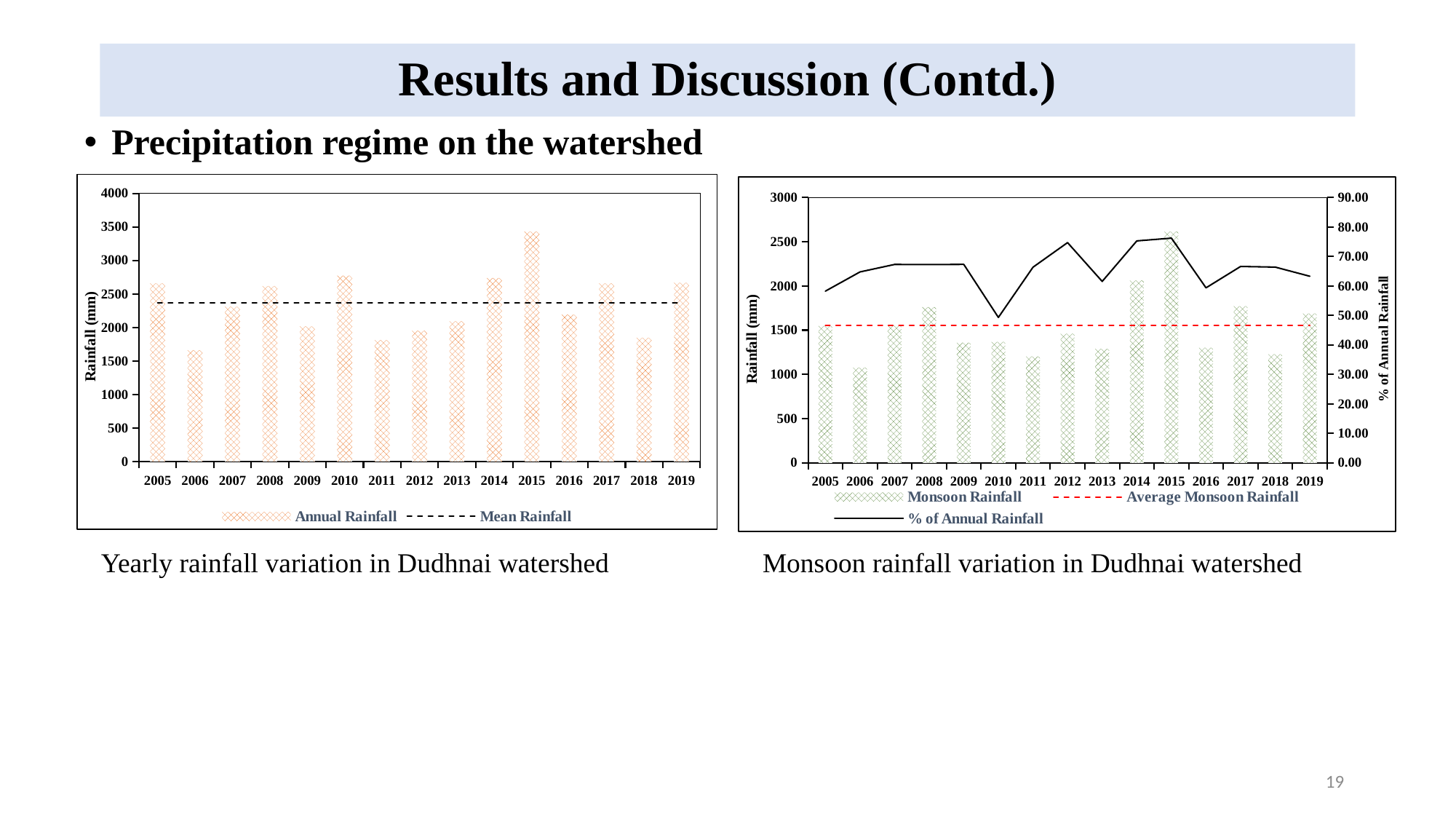
In the left chart (Yearly rainfall variation in Dudhnai watershed), which year has the larger annual rainfall, 2010 or 2011? 2010 In the left chart (Yearly rainfall variation in Dudhnai watershed), how many years are shown on the x axis? 15 In the left chart (Yearly rainfall variation in Dudhnai watershed), is the annual rainfall for 2015 greater or less than 3000? greater In the left chart (Yearly rainfall variation in Dudhnai watershed), is the annual rainfall for 2006 greater or less than 2000? less In the left chart (Yearly rainfall variation in Dudhnai watershed), what kind of chart is used to show Annual Rainfall? bar chart In the right chart (Monsoon rainfall variation in Dudhnai watershed), what is the title of the secondary (right) y axis? % of Annual Rainfall In the right chart (Monsoon rainfall variation in Dudhnai watershed), which year has the highest monsoon rainfall? 2015 In the left chart (Yearly rainfall variation in Dudhnai watershed), which year has the highest annual rainfall? 2015 In the left chart (Yearly rainfall variation in Dudhnai watershed), which year has the lowest annual rainfall? 2006 In the right chart (Monsoon rainfall variation in Dudhnai watershed), how many series does the legend list? 3 In the left chart (Yearly rainfall variation in Dudhnai watershed), how many series does the legend list? 2 In the right chart (Monsoon rainfall variation in Dudhnai watershed), is the monsoon rainfall for 2006 greater or less than 1500? less